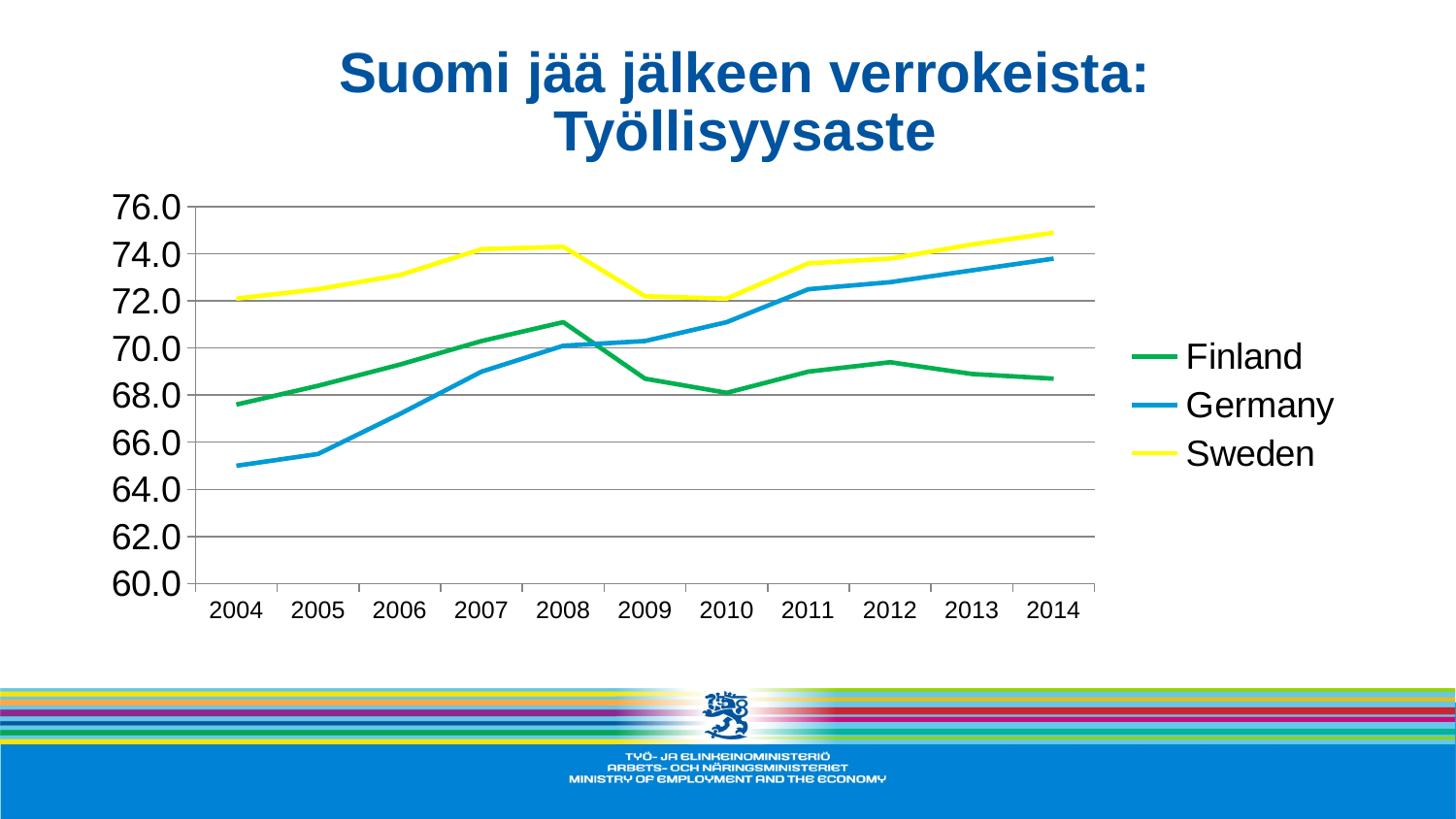
How many years are shown on the x axis? 11 What kind of chart is shown on the slide? line chart Is the value for Germany in 2004 greater or less than 66.0? less Which country has the lowest value in 2004? Germany In 2014, which is higher, Sweden or Finland? Sweden Is the value for Finland in 2012 greater or less than 70.0? less Is the value for Finland in 2010 greater or less than 70.0? less Which country has the highest value in 2004? Sweden Which countries are listed in the legend? Finland, Germany, Sweden Does the Germany line rise or fall from 2004 to 2014? rise How many series does the legend list? 3